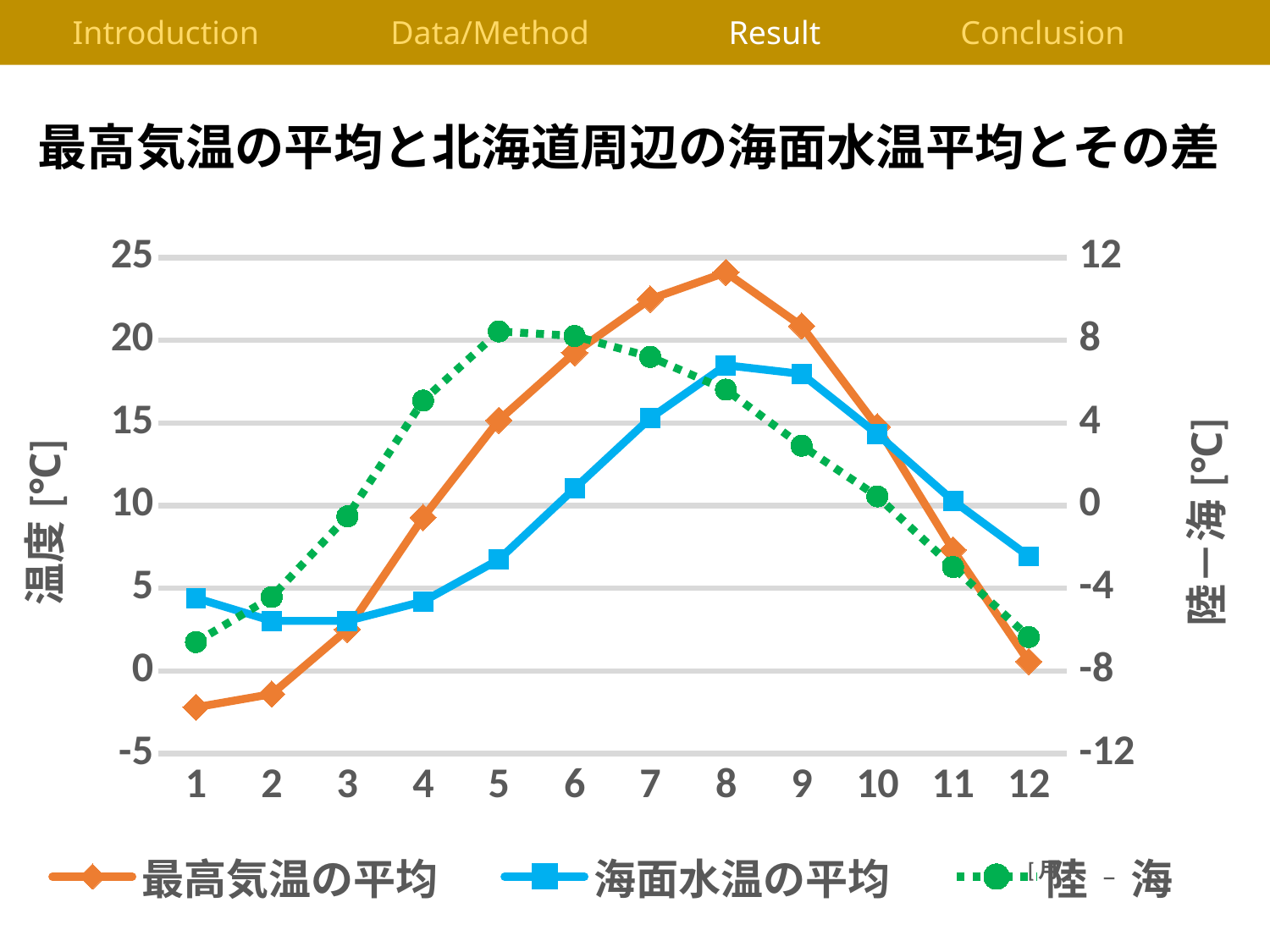
Is the value of 最高気温の平均 in month 1 greater or less than 0? less In which month is 最高気温の平均 lowest? 1 What kind of chart is shown on the slide? line chart Is the value of 陸－海 in month 11 greater or less than 0? less What is the label of the right-hand vertical axis? 陸－海 [°C] In month 1, which is larger: 最高気温の平均 or 海面水温の平均? 海面水温の平均 How many months (points) are plotted along the x axis? 12 In which month is 最高気温の平均 highest? 8 Is the value of 海面水温の平均 in month 6 greater or less than 15? less How many series does the legend list? 3 Does 最高気温の平均 rise or fall from month 1 to month 8? rise